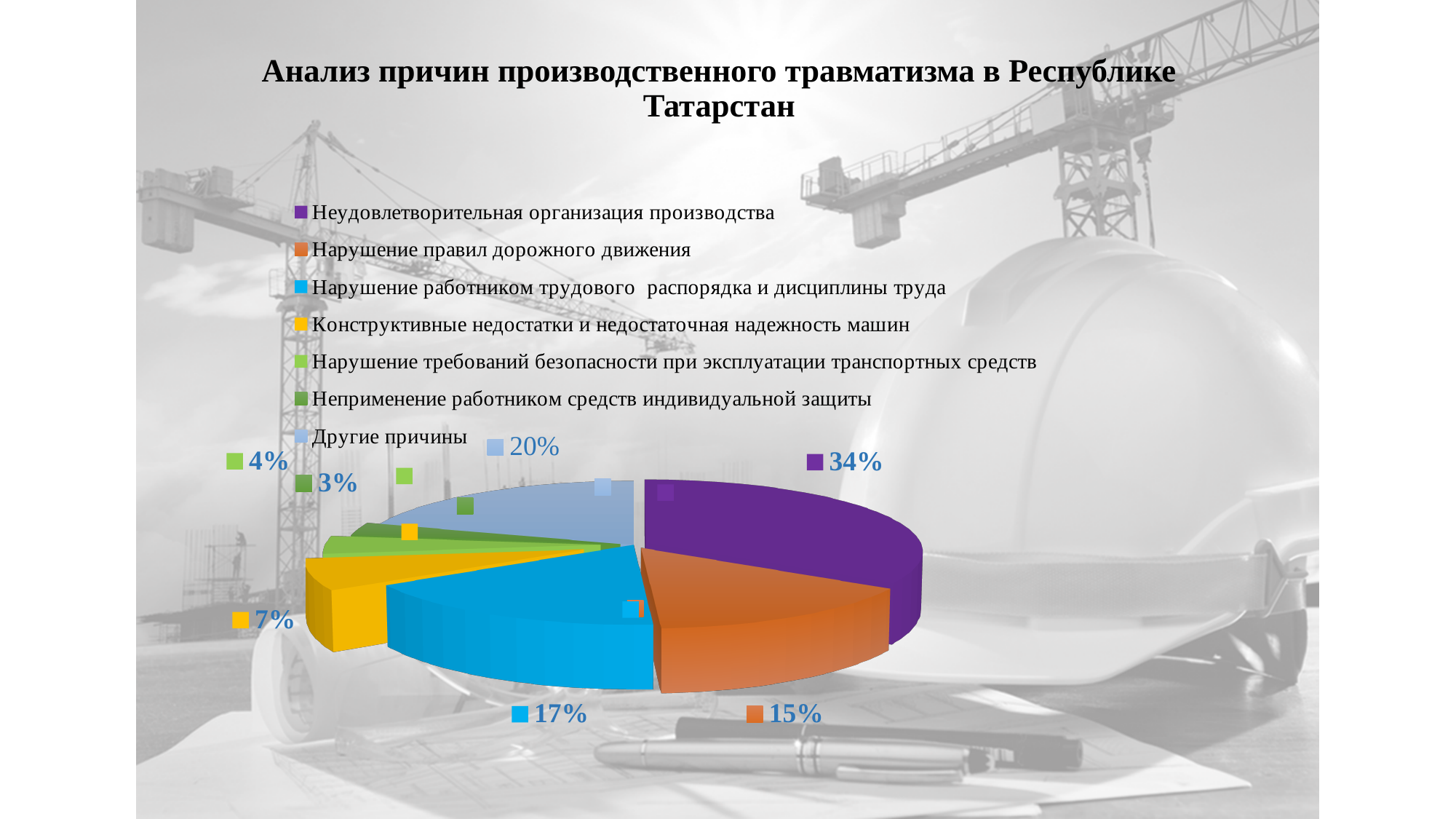
Which category has the smallest share of the pie? Неприменение работником средств индивидуальной защиты What share of the pie is "Нарушение правил дорожного движения"? 15% Which is larger: the share of "Нарушение работником трудового распорядка и дисциплины труда" or the share of "Нарушение правил дорожного движения"? Нарушение работником трудового распорядка и дисциплины труда How many categories does the pie chart have? 7 What is the title of the chart? Анализ причин производственного травматизма в Республике Татарстан What share of the pie is "Другие причины"? 20% What kind of chart is shown on the slide? Pie chart Which category has the largest share of the pie? Неудовлетворительная организация производства What is the difference between the shares of "Неудовлетворительная организация производства" and "Другие причины"? 14% What share of the pie is "Конструктивные недостатки и недостаточная надежность машин"? 7% What share of the pie is "Неудовлетворительная организация производства"? 34% What share of the pie is "Нарушение работником трудового распорядка и дисциплины труда"? 17%